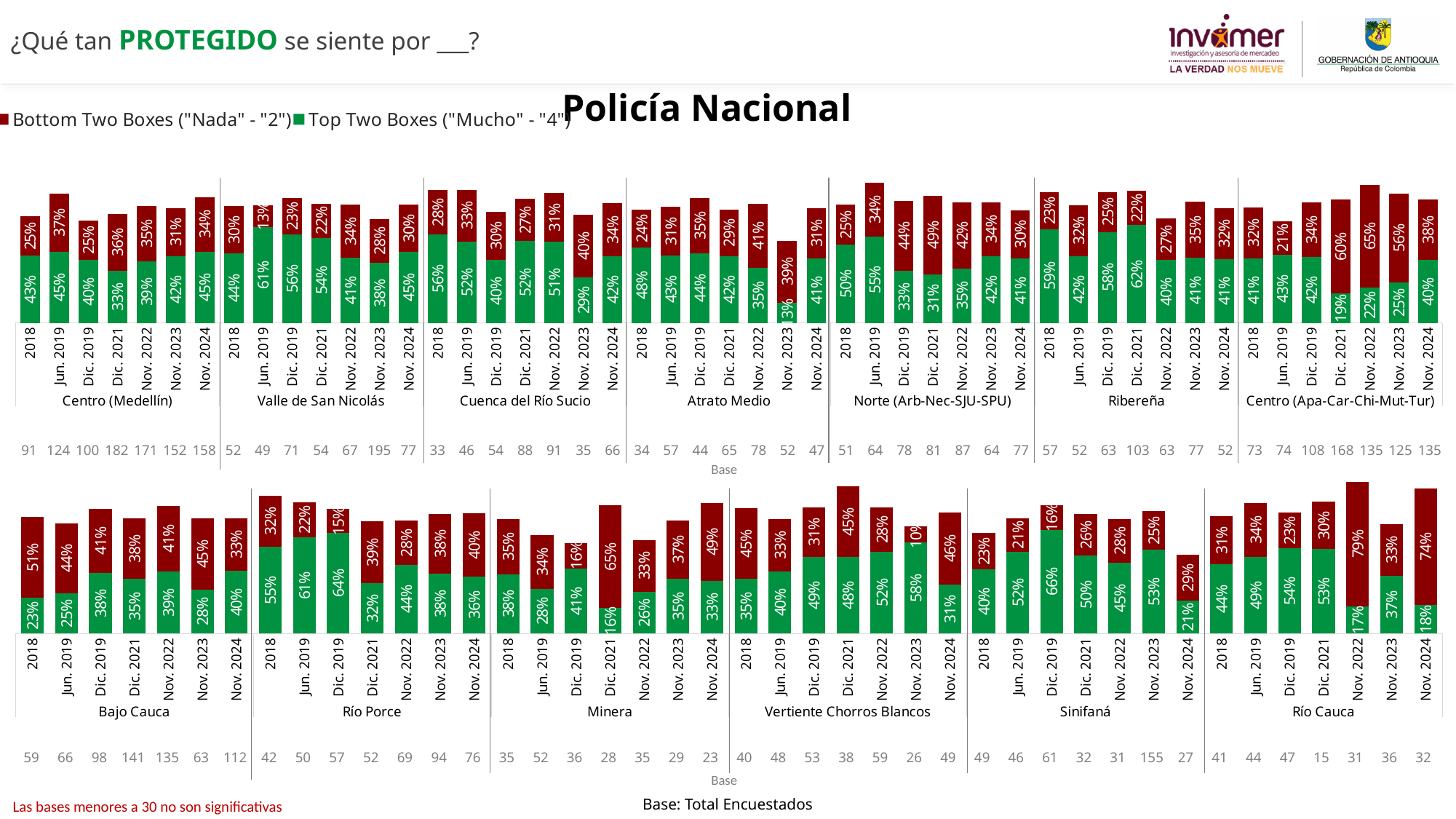
In the bottom chart, what is the combined total of the Top Two Boxes and Bottom Two Boxes for Minera in Dic. 2021? 81% In the top chart, what is the combined total of the Top Two Boxes and Bottom Two Boxes for Valle de San Nicolás in Jun. 2019? 74% What kind of chart is used on this slide? Stacked bar chart In the top chart, what is the Top Two Boxes value for Centro (Medellín) in 2018? 43% How many series does the legend list? 2 In the bottom chart, what is the Top Two Boxes value for Sinifaná in Dic. 2019? 66% In the top chart, what is the Bottom Two Boxes value for Centro (Apa-Car-Chi-Mut-Tur) in Nov. 2022? 65% In the bottom chart, which is larger for Bajo Cauca in 2018: the Top Two Boxes or the Bottom Two Boxes value? Bottom Two Boxes In the top chart, which period has the highest Top Two Boxes value for Ribereña? Dic. 2021 In the top chart, what is the difference between the Bottom Two Boxes and Top Two Boxes values for Atrato Medio in Nov. 2023? 26% In the bottom chart, which period has the lowest Top Two Boxes value for Río Cauca? Nov. 2022 In the bottom chart, what is the Bottom Two Boxes value for Río Cauca in Nov. 2022? 79%